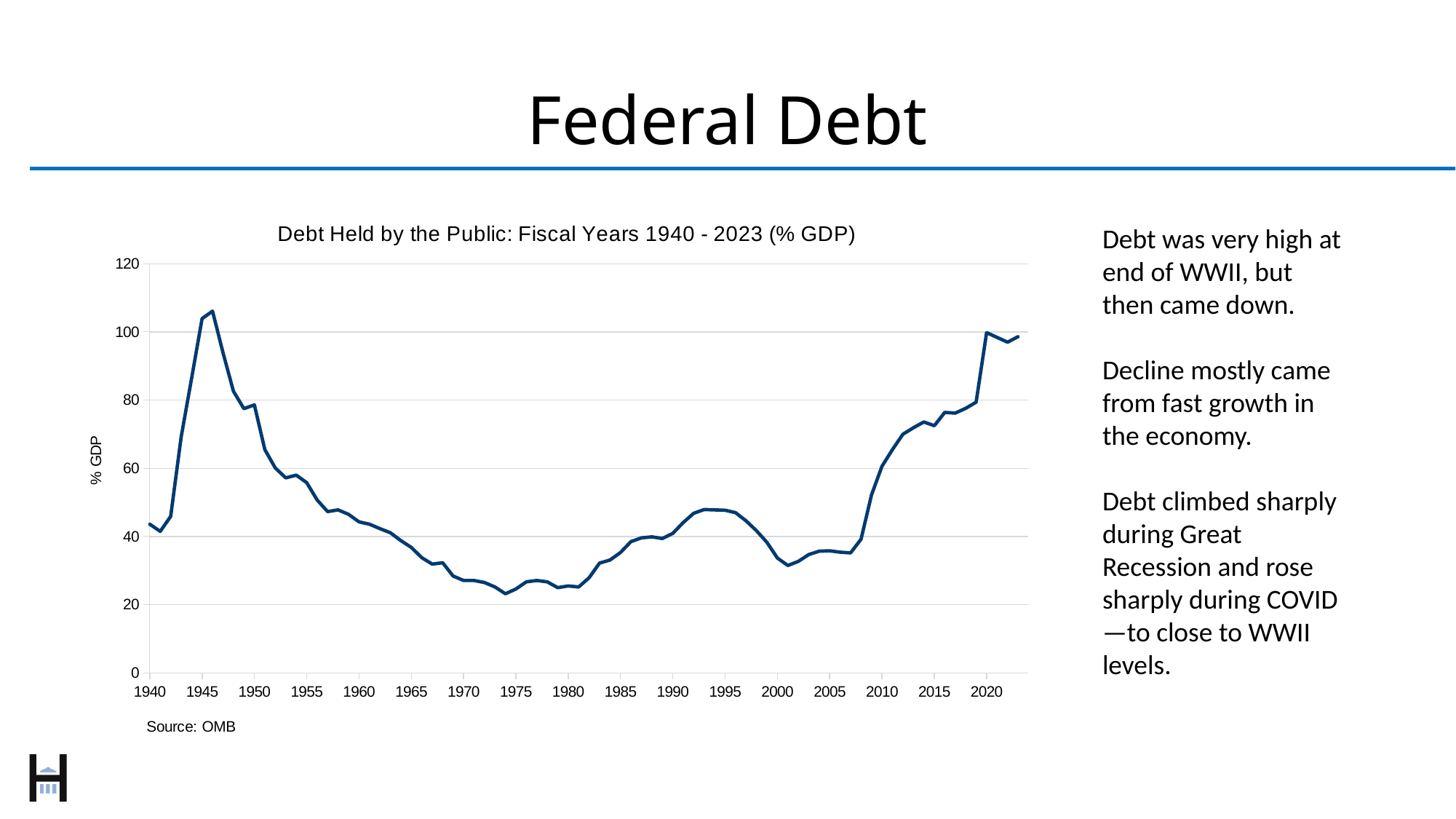
Is the value for 2015 greater or less than 60? greater Is the value for 1960 greater or less than 40? greater Around which year does debt held by the public reach its highest level on the chart? 1946 Is the value for 1974 greater or less than 40? less What is the title of the chart? Debt Held by the Public: Fiscal Years 1940 - 2023 (% GDP) Does the value rise or fall between 1946 and 1974? fall Does the value rise or fall between 2008 and 2012? rise What kind of chart is shown on the slide? line chart What is the label on the vertical axis of the chart? % GDP